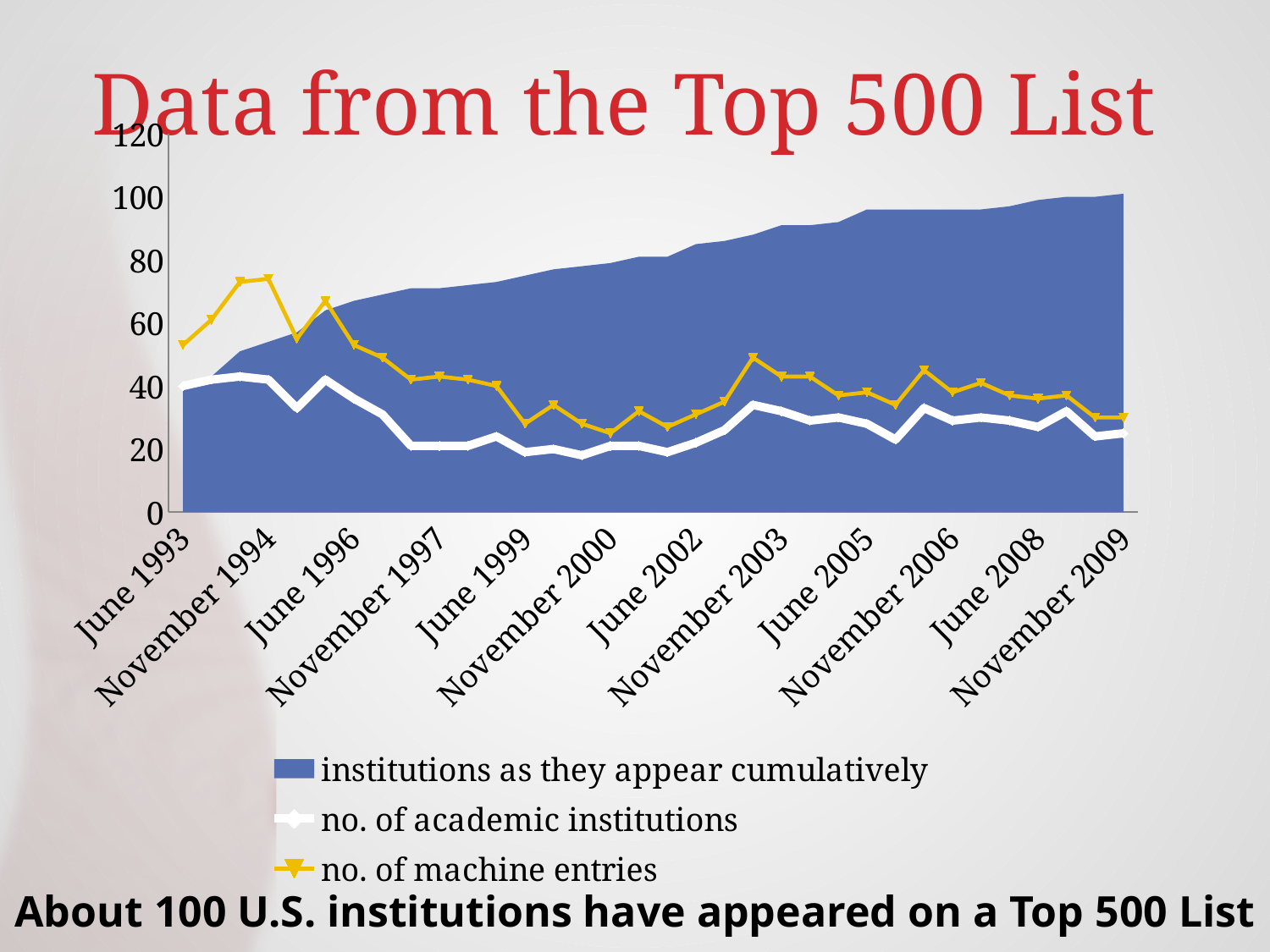
Which series has the lowest value at November 2009? no. of academic institutions At June 1993, which is larger: 'no. of machine entries' or 'no. of academic institutions'? no. of machine entries Does the 'no. of machine entries' series overall rise or fall from June 1993 to November 2009? fall What is the title of the chart? Data from the Top 500 List Is the value for 'no. of academic institutions' at November 2000 greater or less than 30? less Is the value for 'no. of machine entries' at June 1993 greater or less than 40? greater Which series is shown as the blue filled area? institutions as they appear cumulatively What kind of chart is this? area and line chart Is the value for 'institutions as they appear cumulatively' at November 2009 greater or less than 80? greater How many series does the legend list? 3 Does the 'institutions as they appear cumulatively' series rise or fall from June 1993 to November 2009? rise